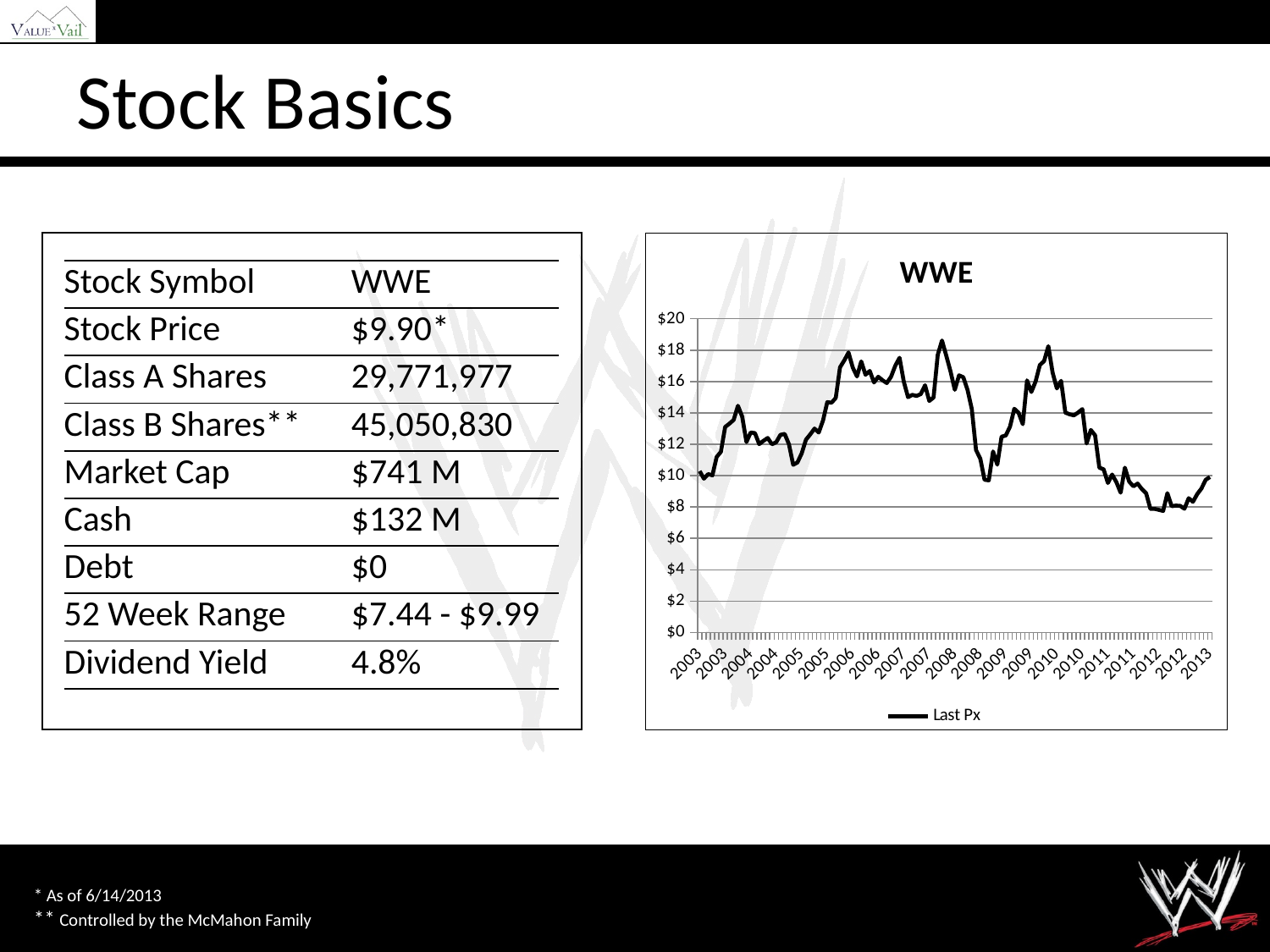
Is the Last Px value in 2006 higher or lower than the value in 2012? higher Is the highest value reached by the Last Px line greater or less than $16? greater What is the title of the chart? WWE Does the Last Px line generally rise or fall between 2003 and 2006? rise How many series does the chart legend list? 1 What is the name of the series shown in the chart legend? Last Px Does the Last Px line generally rise or fall between 2010 and 2012? fall What is the maximum value shown on the chart's vertical axis? $20 What kind of chart is shown on the slide? line chart Is the lowest value reached by the Last Px line greater or less than $10? less Is the Last Px value during 2006 greater or less than $14? greater